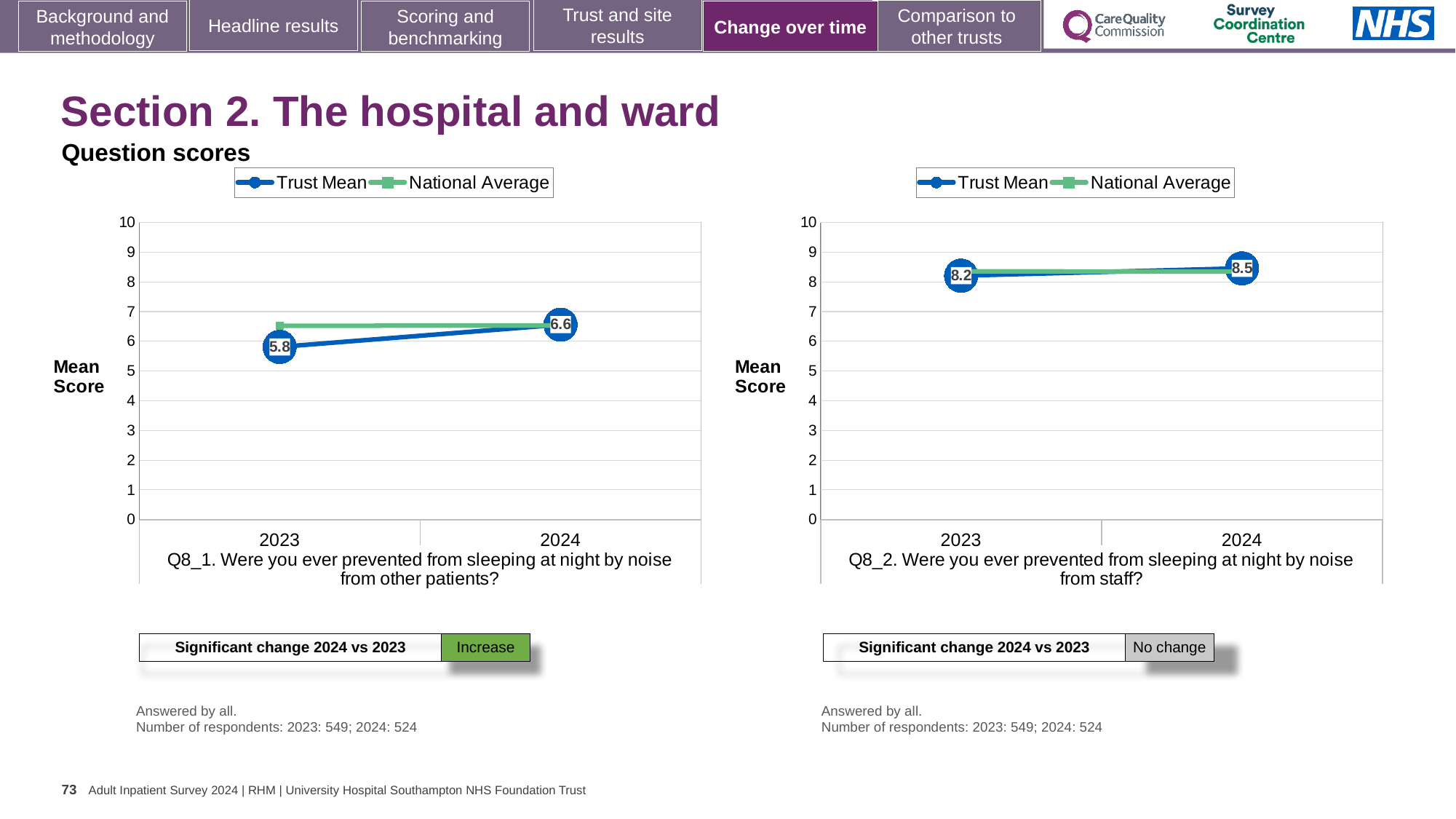
In the Q8_1 chart (left), does the Trust Mean rise or fall from 2023 to 2024? rise How many series does the legend of the Q8_2 chart (right) list? 2 In the Q8_1 chart (left), by how much did the Trust Mean change from 2023 to 2024? 0.8 In the Q8_2 chart (right), what is the Trust Mean for 2024? 8.5 In the Q8_2 chart (right), is the National Average for 2023 greater or less than 8? greater What kind of chart is the Q8_1 chart (left)? line chart In the Q8_2 chart (right), what is the Trust Mean for 2023? 8.2 In the Q8_1 chart (left), is the Trust Mean for 2023 greater or less than the National Average for 2023? less In the Q8_1 chart (left), what is the Trust Mean for 2023? 5.8 In the Q8_2 chart (right), what is the difference between the Trust Mean in 2024 and in 2023? 0.3 What significant change result is shown below the Q8_2 chart (right)? No change In the Q8_1 chart (left), what is the Trust Mean for 2024? 6.6